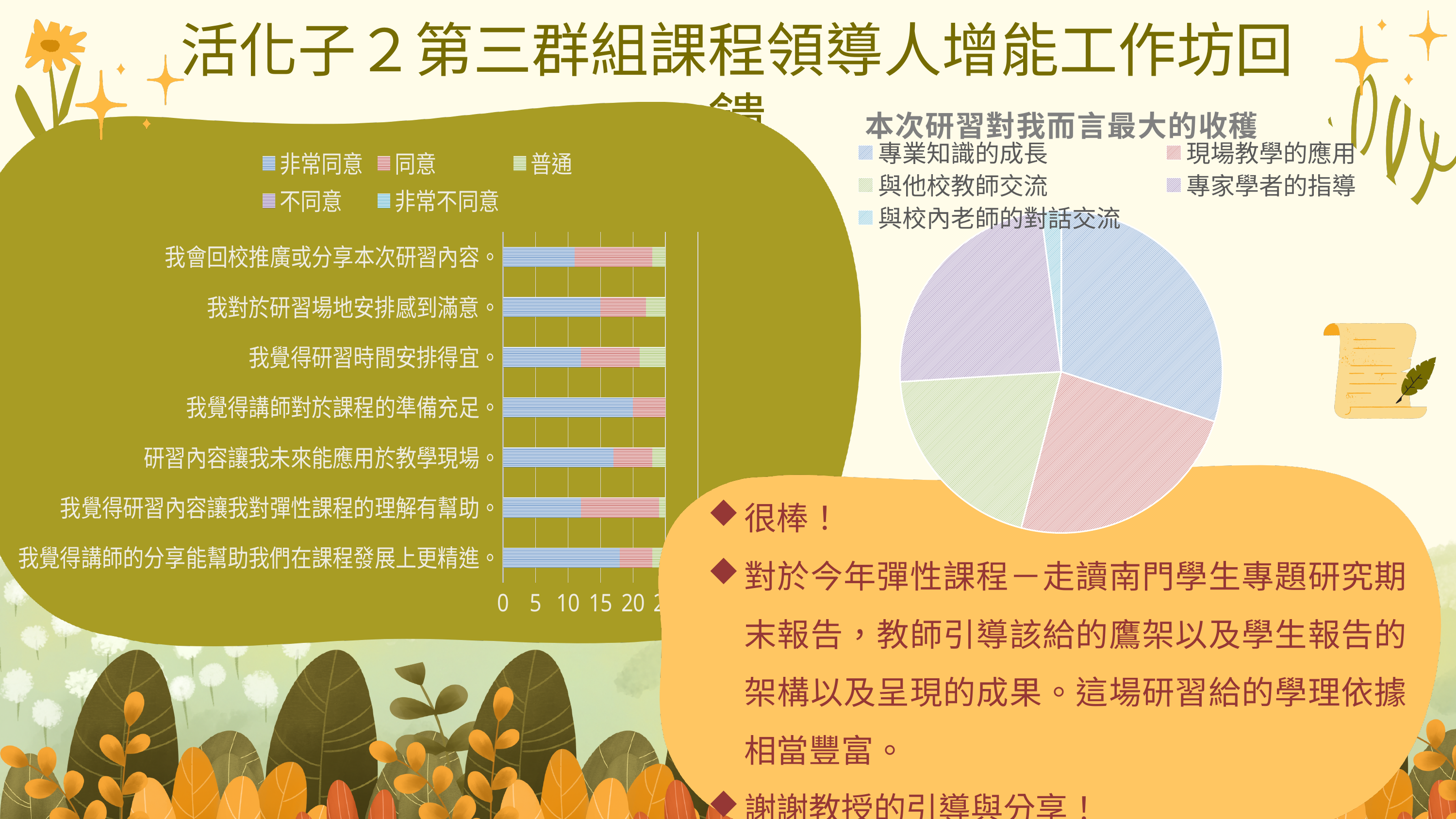
In the bar chart on the left, is the 非常同意 value for 我對於研習場地安排感到滿意 greater or less than 10? greater In the bar chart on the left, how many series does the legend list? 5 In the bar chart on the left, which legend entry is shown in blue? 非常同意 In the pie chart titled 本次研習對我而言最大的收穫, how many categories does the legend list? 5 In the pie chart titled 本次研習對我而言最大的收穫, which category has the smallest slice? 與校內老師的對話交流 In the bar chart on the left, is the 非常同意 value for 我覺得講師對於課程的準備充足 greater or less than 15? greater In the bar chart on the left, how many statements (categories) are plotted? 7 In the bar chart on the left, is the 非常同意 segment for 我覺得講師對於課程的準備充足 longer or shorter than that for 我覺得研習時間安排得宜? longer What kind of chart is the chart titled 本次研習對我而言最大的收穫? pie chart In the bar chart on the left, which statement has the longest 非常同意 segment? 我覺得講師對於課程的準備充足。 In the bar chart on the left, is the 非常同意 value for 我覺得研習時間安排得宜 greater or less than 15? less What kind of chart is the chart on the left side of the slide? bar chart